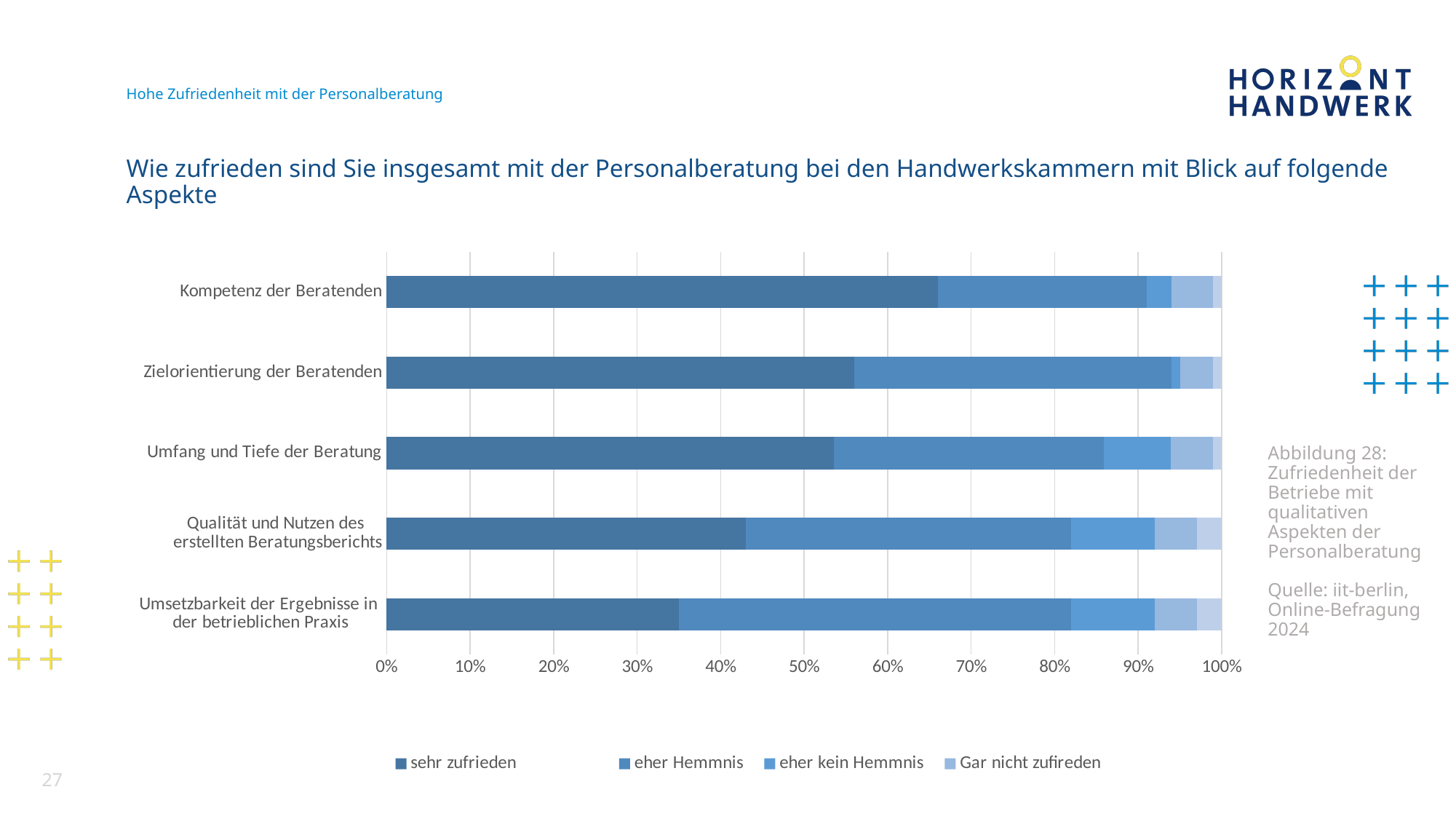
Which category has the largest 'sehr zufrieden' share? Kompetenz der Beratenden Is the 'sehr zufrieden' share for Kompetenz der Beratenden greater or less than 60%? greater What kind of chart is shown on the slide? Stacked bar chart Is the 'sehr zufrieden' share for Umsetzbarkeit der Ergebnisse in der betrieblichen Praxis greater or less than 40%? less Which has a larger 'sehr zufrieden' share: Umfang und Tiefe der Beratung or Qualität und Nutzen des erstellten Beratungsberichts? Umfang und Tiefe der Beratung Is the 'sehr zufrieden' share for Qualität und Nutzen des erstellten Beratungsberichts greater or less than 50%? less Does the 'sehr zufrieden' share increase or decrease going from the top category to the bottom category? decrease What is the last entry listed in the chart legend? Gar nicht zufireden How many categories (aspects) are plotted on the chart? 5 How many series does the chart legend list? 4 Which category has the smallest 'sehr zufrieden' share? Umsetzbarkeit der Ergebnisse in der betrieblichen Praxis